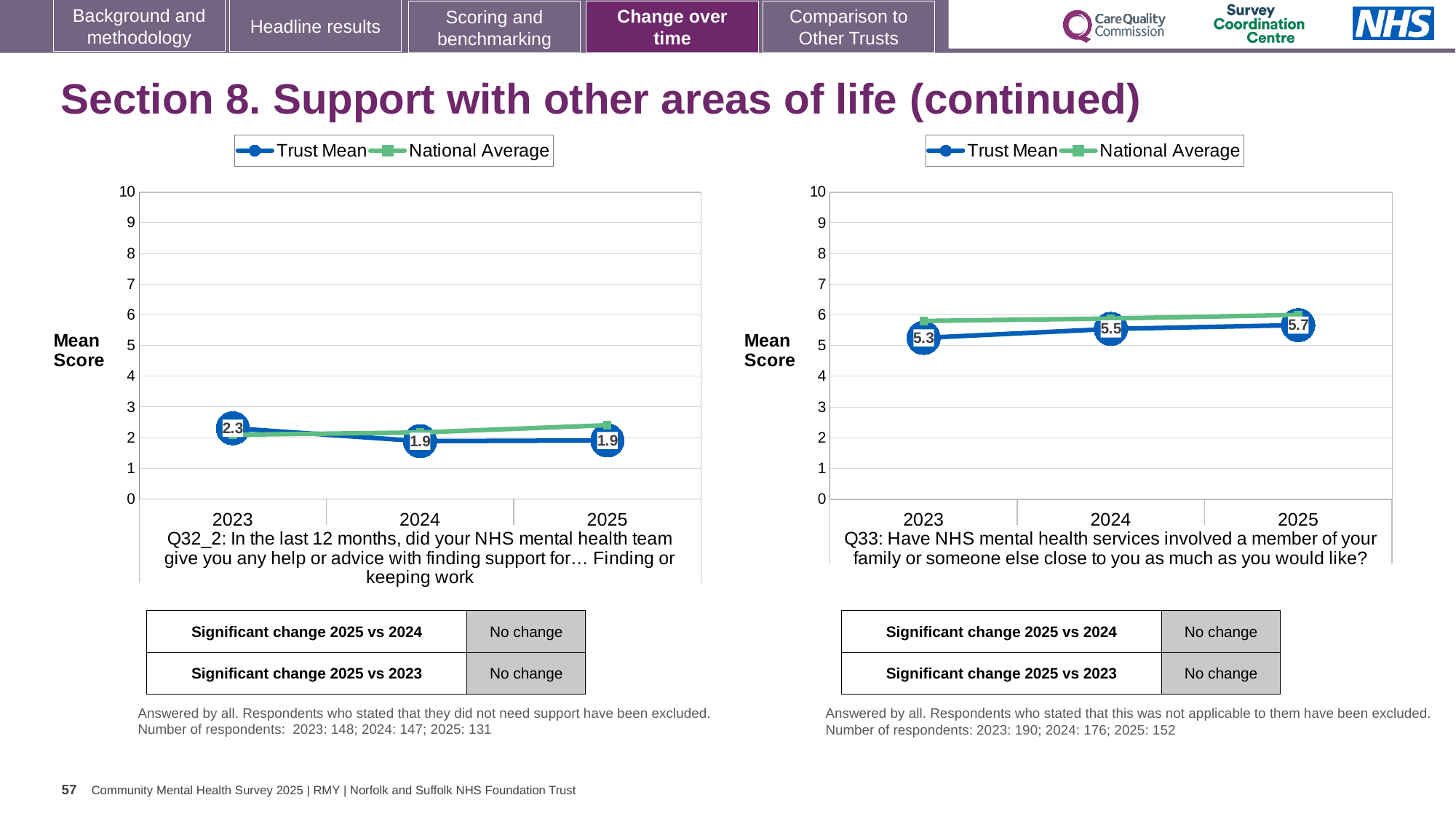
What kind of chart is the right chart (Q33)? line chart In the left chart (Q32_2), what is the Trust Mean for 2025? 1.9 In the right chart (Q33), what is the Trust Mean for 2025? 5.7 How many series does the legend of the left chart list? 2 In the right chart (Q33), is the National Average for 2025 greater or less than 5? greater In the right chart (Q33), does the Trust Mean rise or fall from 2023 to 2025? rise In the right chart (Q33), what is the difference between the Trust Mean in 2025 and in 2023? 0.4 In the left chart (Q32_2), which year has the highest Trust Mean? 2023 In the left chart (Q32_2), what is the Trust Mean for 2023? 2.3 In the left chart (Q32_2), what is the difference between the Trust Mean in 2023 and in 2024? 0.4 In the right chart (Q33), which year has the highest Trust Mean? 2025 In the right chart (Q33), what is the Trust Mean for 2024? 5.5